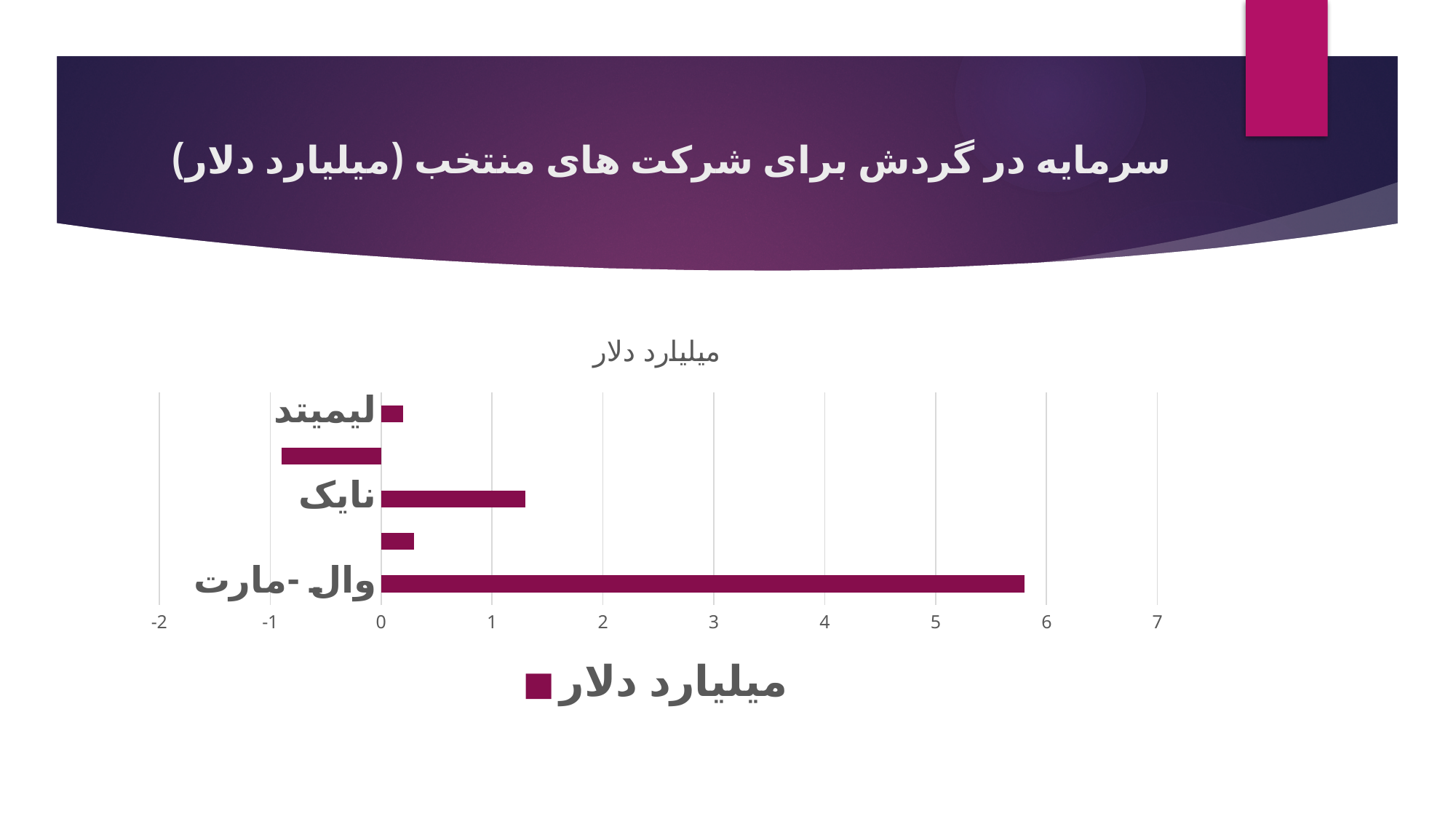
Which is larger, the value for نایک or the value for لیمیتد? نایک What is the legend entry shown below the chart? میلیارد دلار How many bars are plotted in the chart? 5 Which is larger, the value for وال-مارت or the value for نایک? وال-مارت How many series does the legend list? 1 Is the value for نایک greater or less than 1? greater Is the value for وال-مارت greater or less than 5? greater Which company has the highest value in the chart? وال-مارت Is the value for لیمیتد greater or less than 1? less What type of chart is shown on the slide? bar chart What is the title of the chart? میلیارد دلار